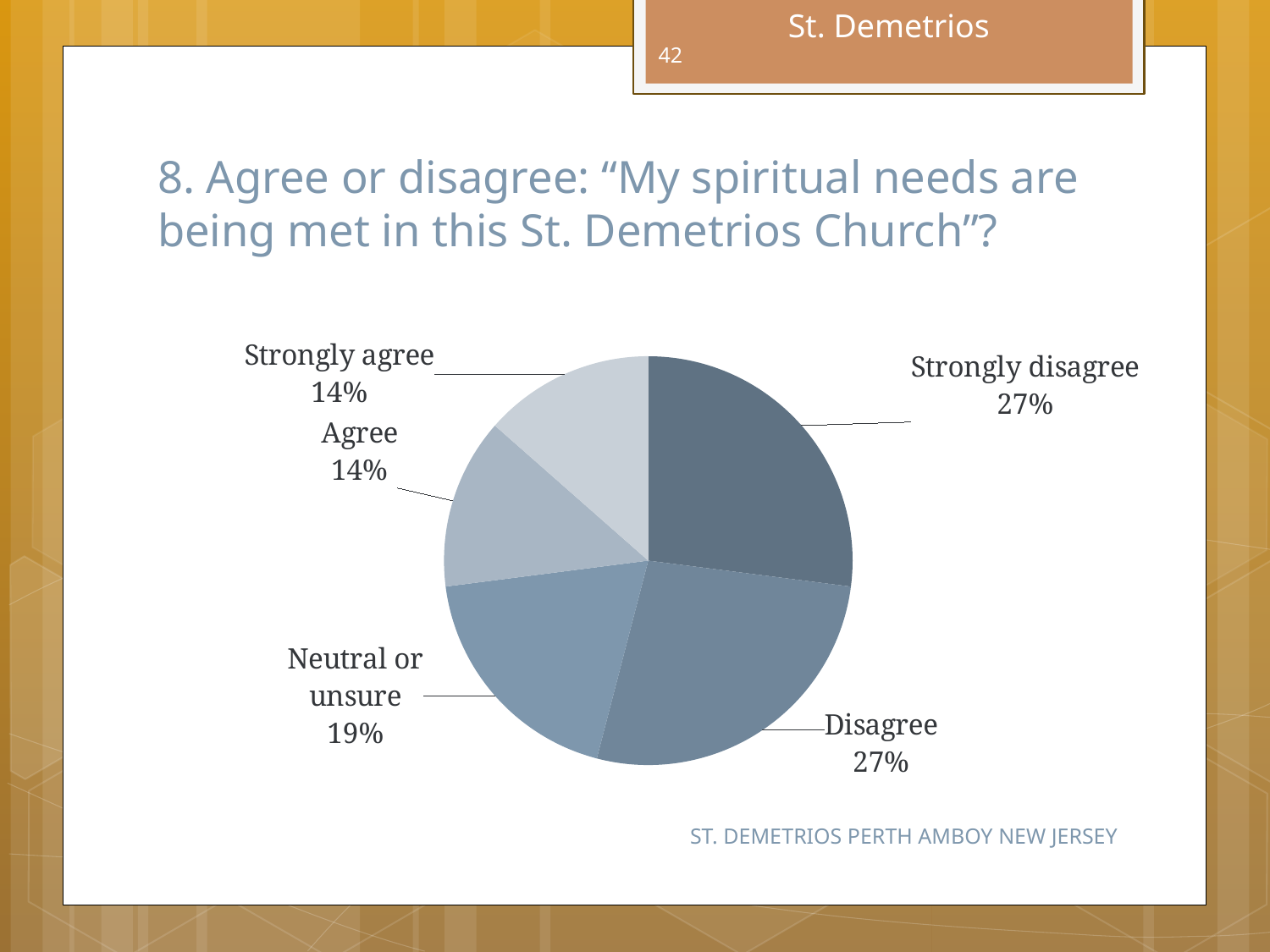
What type of chart is shown on the slide? Pie chart What is the difference in percentage points between "Strongly disagree" and "Neutral or unsure"? 8 percentage points What is the difference in percentage points between "Neutral or unsure" and "Agree"? 5 percentage points What percentage of respondents answered "Neutral or unsure"? 19% What percentage of respondents answered "Agree"? 14% What is the combined percentage of "Strongly disagree" and "Disagree"? 54% What percentage of respondents answered "Strongly agree"? 14% What percentage of respondents answered "Strongly disagree"? 27% How many slices does the pie chart have? 5 Which is larger, the "Strongly disagree" slice or the "Strongly agree" slice? Strongly disagree Which is larger, the "Neutral or unsure" slice or the "Agree" slice? Neutral or unsure What share of the pie does the "Disagree" slice represent? 27%